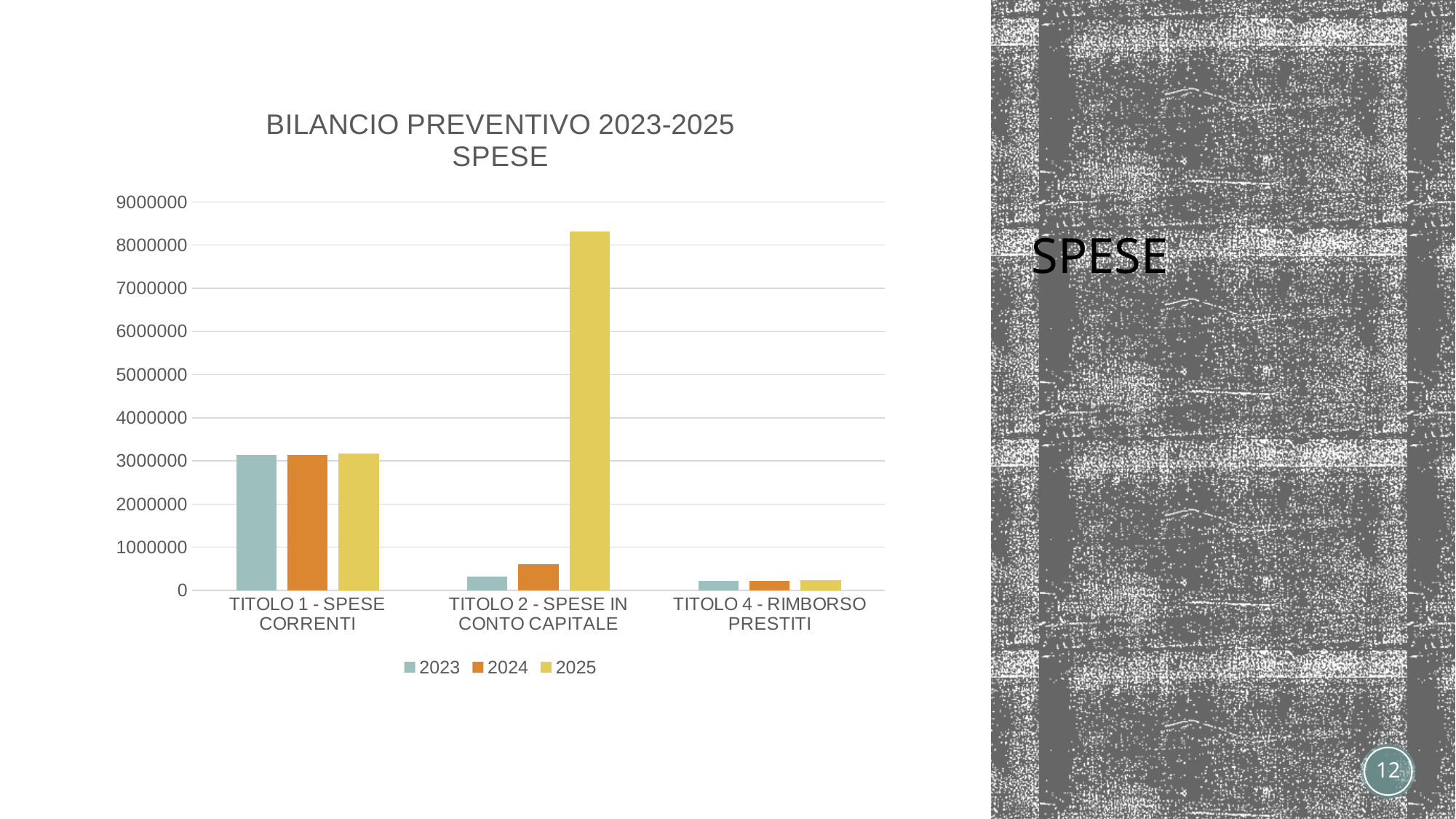
For TITOLO 2 - SPESE IN CONTO CAPITALE, which is larger: the 2023 value or the 2024 value? 2024 For 2023, which is larger: TITOLO 1 - SPESE CORRENTI or TITOLO 2 - SPESE IN CONTO CAPITALE? TITOLO 1 - SPESE CORRENTI Which category has the lowest value for 2023? TITOLO 4 - RIMBORSO PRESTITI How many categories are shown on the x axis? 3 Is the 2025 value for TITOLO 2 - SPESE IN CONTO CAPITALE greater or less than 8000000? greater Is the 2023 value for TITOLO 1 - SPESE CORRENTI greater or less than 2000000? greater How many series does the legend list? 3 Which category has the highest value for 2025? TITOLO 2 - SPESE IN CONTO CAPITALE What are the entries listed in the chart legend? 2023, 2024, 2025 What is the title of the chart? BILANCIO PREVENTIVO 2023-2025 SPESE Is the 2024 value for TITOLO 2 - SPESE IN CONTO CAPITALE greater or less than 1000000? less What kind of chart is shown on the slide? bar chart